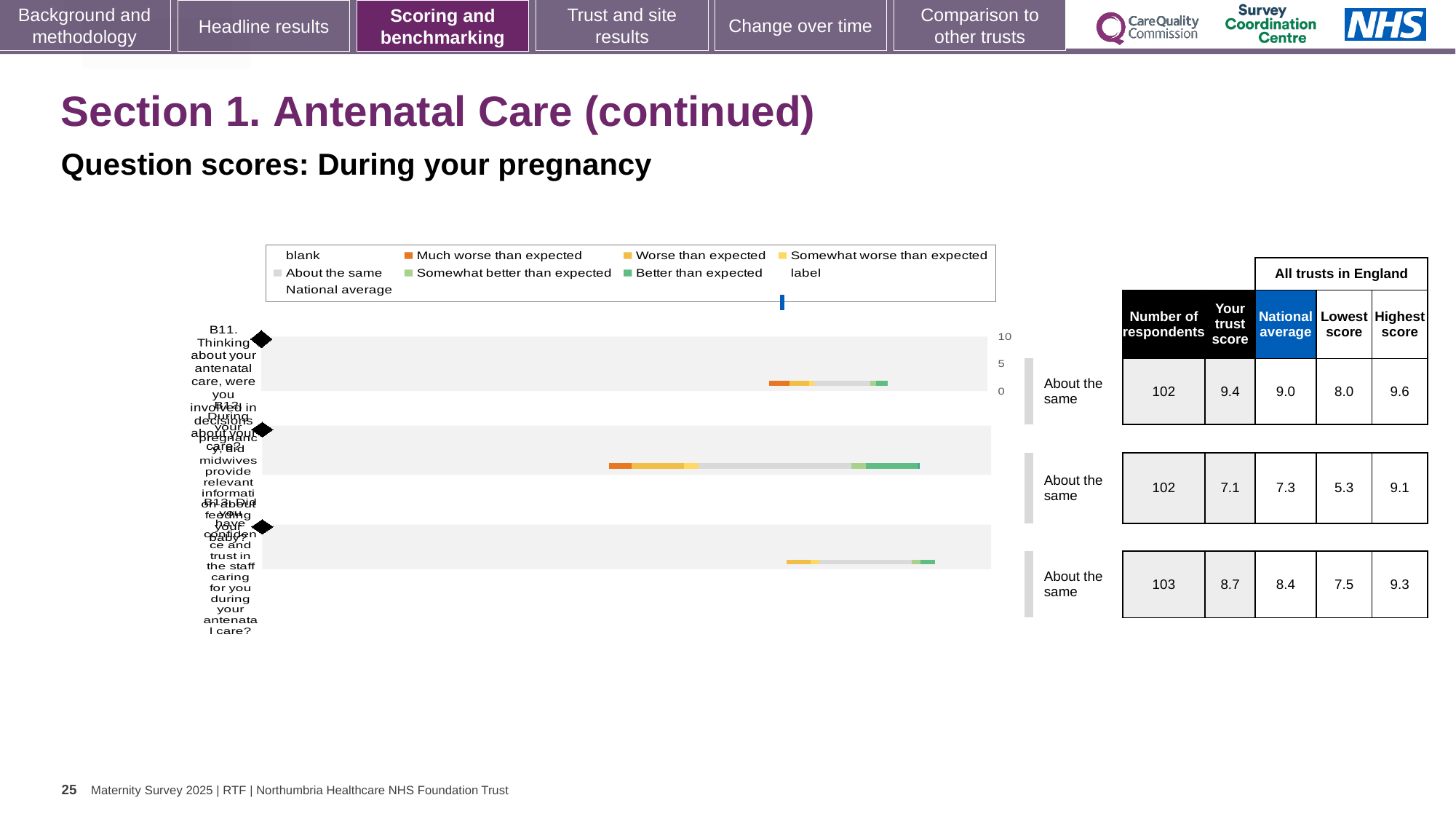
According to the table beside the chart, what is the trust score for B11 (involved in decisions about your antenatal care)? 9.4 Which question has the lowest trust score in the table beside the chart? B12 According to the table beside the chart, what is the national average for B12 (midwives provide relevant information about feeding your baby)? 7.3 What is the difference between the trust score and the national average for B11 in the table beside the chart? 0.4 According to the table beside the chart, how many respondents answered B13 (confidence and trust in the staff caring for you)? 103 How many questions (bars) are plotted in the chart? 3 What kind of chart is shown on the slide? bar chart Which question has the highest trust score in the table beside the chart? B11 What is the highest value shown on the chart's axis? 10 What is the difference between the highest score and the lowest score for B12 in the table beside the chart? 3.8 What benchmark category is shown next to each bar in the chart? About the same For B12, which is larger in the table beside the chart: the trust score or the national average? National average